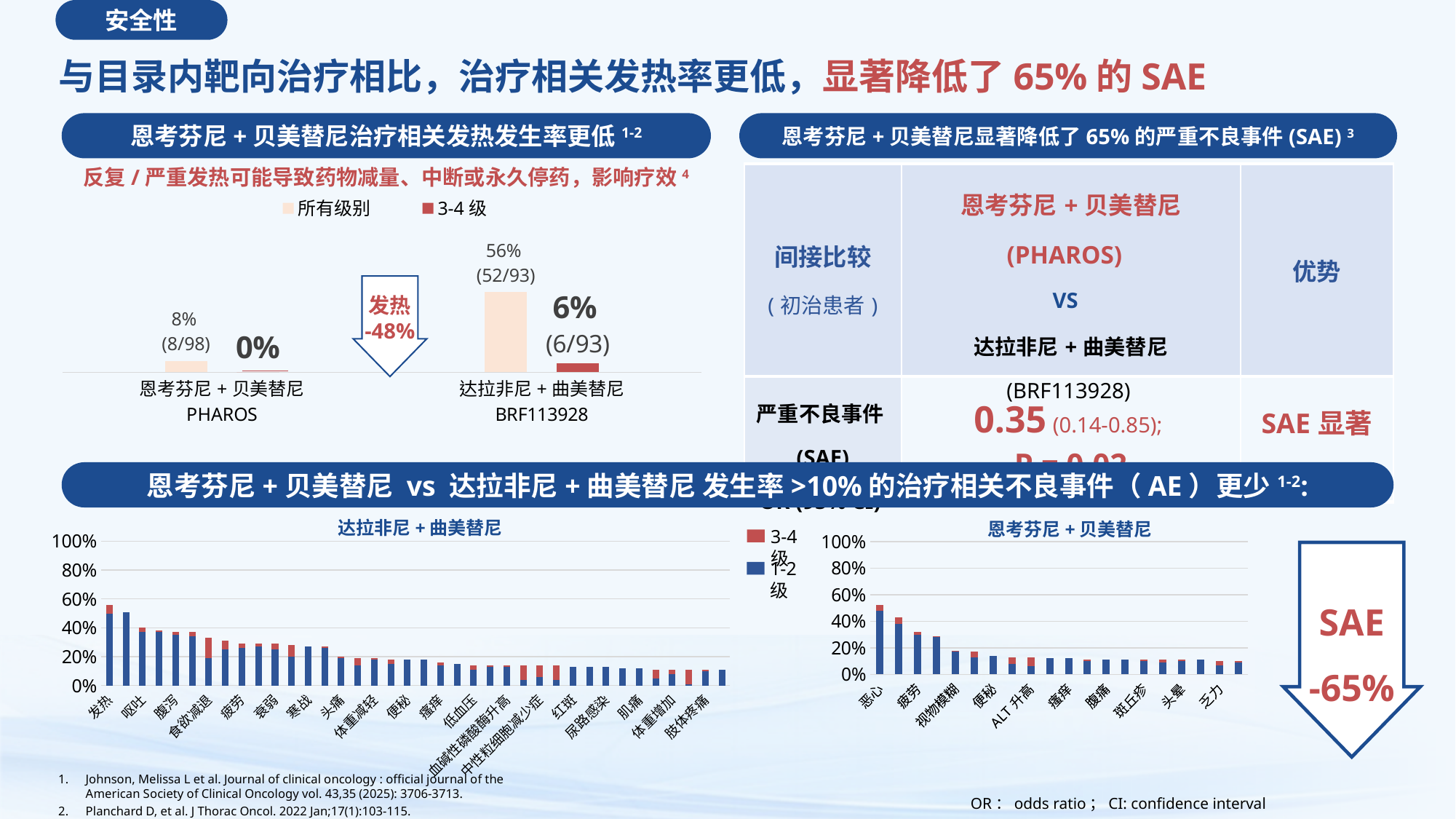
In the bottom-right chart (恩考芬尼 + 贝美替尼), which adverse event has the highest rate? 恶心 In the top-left fever chart, what is the grade 3-4 fever rate for 恩考芬尼 + 贝美替尼? 0% In the top-left fever chart, how many series does the legend list? 2 In the top-left fever chart, what is the difference between the all-grade fever rates of 达拉非尼 + 曲美替尼 and 恩考芬尼 + 贝美替尼? 48% In the top-left fever chart, what is the grade 3-4 fever rate for 达拉非尼 + 曲美替尼? 6% In the bottom-left chart (达拉非尼 + 曲美替尼), which adverse event has the highest rate? 发热 In the bottom-left chart (达拉非尼 + 曲美替尼), how many adverse event categories are shown? 38 In the bottom-right chart (恩考芬尼 + 贝美替尼), how many adverse event categories are shown? 20 In the top-left fever chart, what is the all-grade fever rate for 恩考芬尼 + 贝美替尼 (PHAROS)? 8% In the bottom-left chart (达拉非尼 + 曲美替尼), is the total value for 发热 greater or less than 40%? greater In the top-left fever chart, what is the all-grade fever rate for 达拉非尼 + 曲美替尼 (BRF113928)? 56% What kind of chart is the bottom-right chart (恩考芬尼 + 贝美替尼)? Stacked bar chart